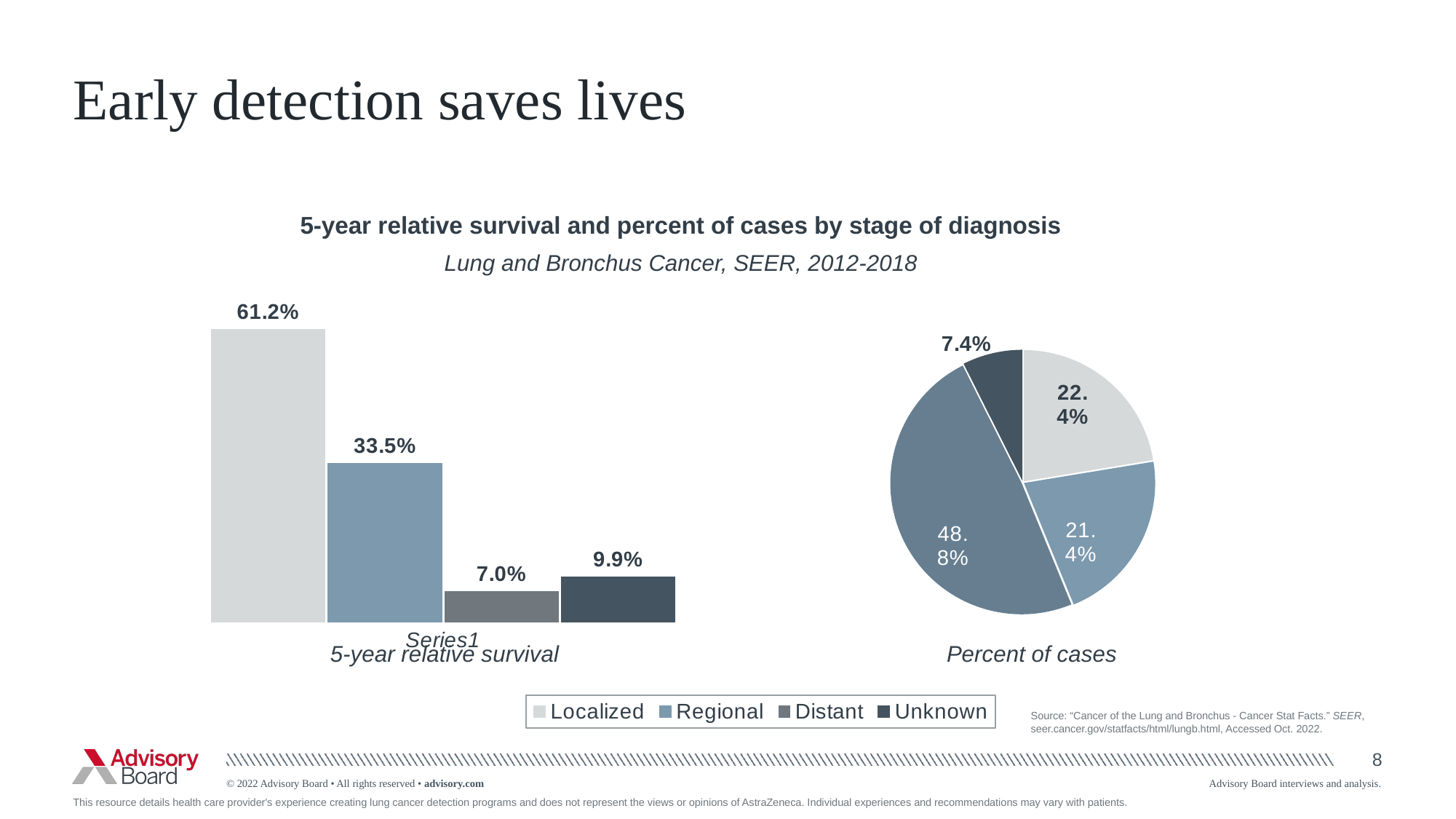
In the 5-year relative survival bar chart, what is the value for Regional? 33.5% In the Percent of cases pie chart, what share of cases is Distant? 48.8% In the 5-year relative survival bar chart, which stage has the lowest survival value? Distant In the Percent of cases pie chart, what share of cases is Unknown? 7.4% In the 5-year relative survival bar chart, what is the value for Localized? 61.2% In the 5-year relative survival bar chart, which is larger, the value for Unknown or the value for Distant? Unknown In the 5-year relative survival bar chart, which stage has the highest survival value? Localized In the 5-year relative survival bar chart, what is the difference between the Localized and Regional values? 27.7% In the 5-year relative survival bar chart, what is the value for Distant? 7.0% How many entries does the legend list? 4 In the Percent of cases pie chart, which stage accounts for the largest share of cases? Distant What type of chart is the one on the left showing 5-year relative survival? Bar chart